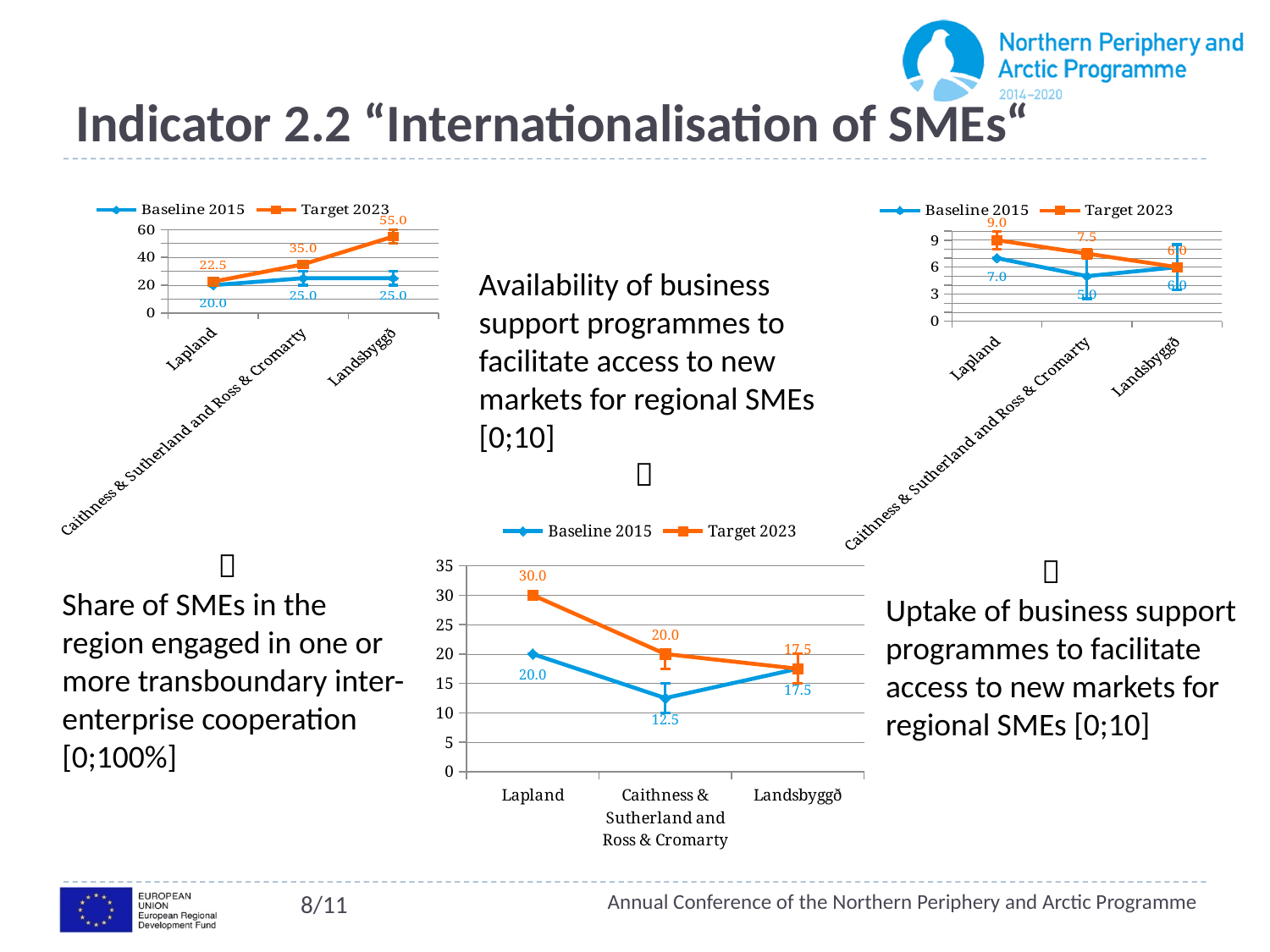
In the chart at the top right of the slide, what is the Baseline 2015 value for Lapland? 7.0 In the chart at the top left of the slide, what is the Baseline 2015 value for Lapland? 20.0 In the chart at the bottom centre of the slide, which category has the highest Target 2023 value? Lapland In the chart at the bottom centre of the slide, what is the Target 2023 value for Lapland? 30.0 In the chart at the top left of the slide, which category has the lowest Target 2023 value? Lapland In the chart at the top right of the slide, is the Target 2023 value for Lapland larger or smaller than the Target 2023 value for Landsbyggð? larger In the chart at the top right of the slide, what is the Target 2023 value for Caithness & Sutherland and Ross & Cromarty? 7.5 In the chart at the top left of the slide, what is the Target 2023 value for Landsbyggð? 55.0 In the chart at the bottom centre of the slide, what is the difference between the Target 2023 and Baseline 2015 values for Lapland? 10.0 What type of chart is the chart at the top left of the slide? line chart How many series does the legend of the chart at the bottom centre of the slide list? 2 In the chart at the bottom centre of the slide, what is the Baseline 2015 value for Caithness & Sutherland and Ross & Cromarty? 12.5